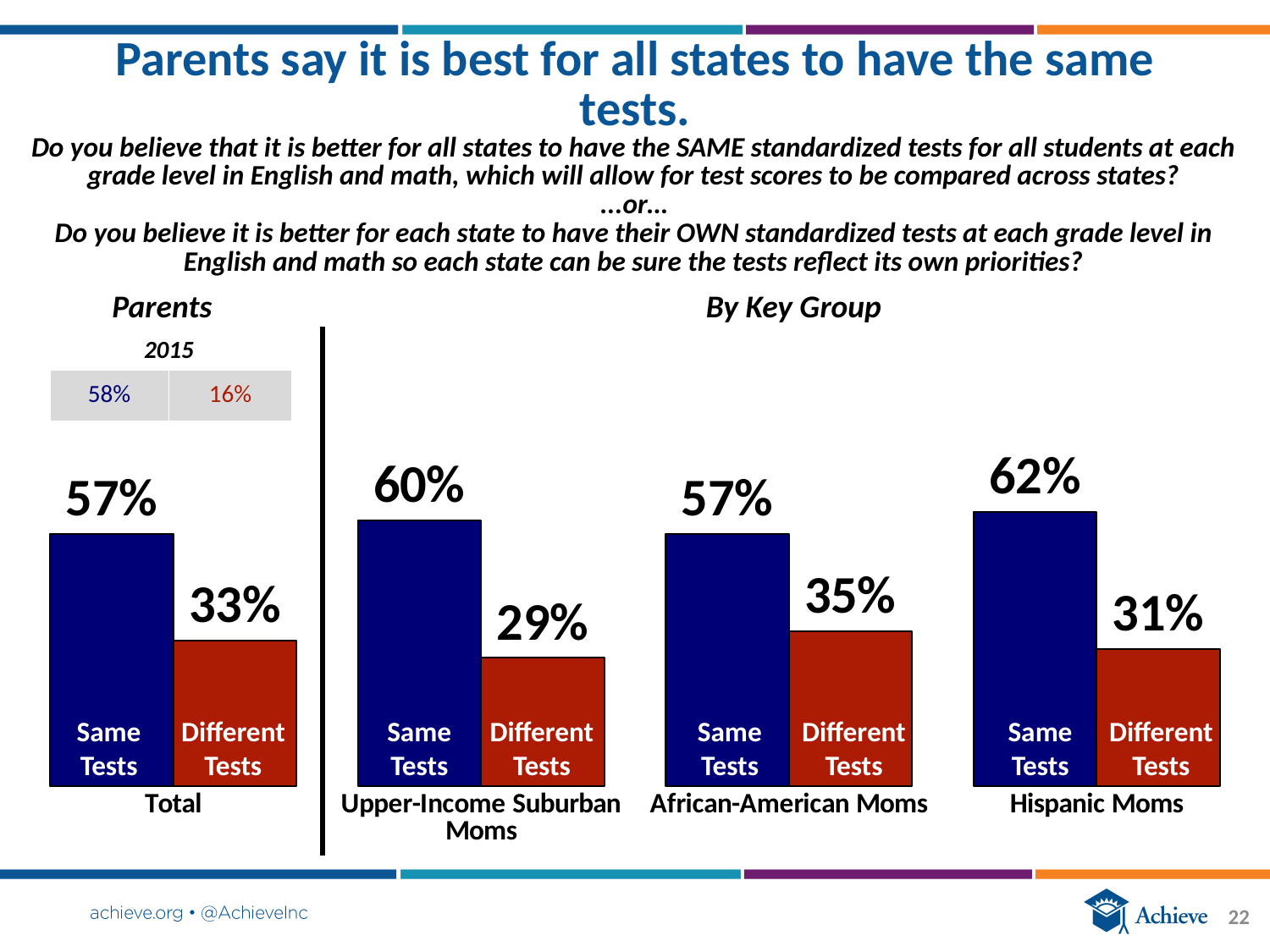
What type of chart is used to show the results? Bar chart What percentage of African-American Moms chose Same Tests? 57% What is the difference between Same Tests and Different Tests for the Total group? 24% Which group has the lowest percentage choosing Different Tests? Upper-Income Suburban Moms How many groups are shown in the bar charts? 4 What percentage of Hispanic Moms chose Different Tests? 31% Which group has the highest percentage choosing Same Tests? Hispanic Moms What percentage of Upper-Income Suburban Moms chose Different Tests? 29% Which is larger for African-American Moms: Same Tests or Different Tests? Same Tests What colour are the Same Tests bars? Dark blue What percentage of the Total group chose Same Tests? 57% What is the difference between Same Tests and Different Tests for Hispanic Moms? 31%